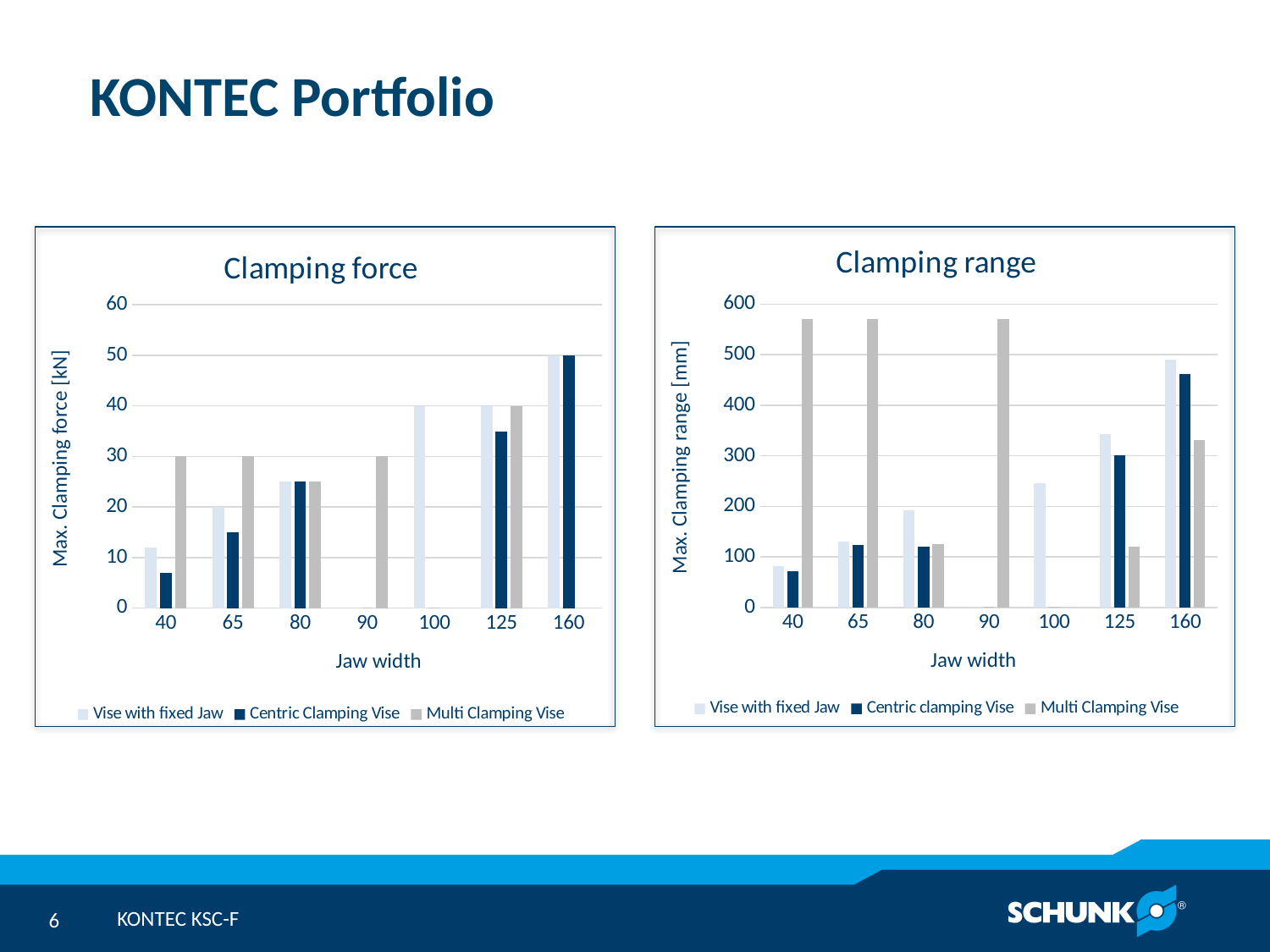
In the Clamping force chart, what kind of chart is shown? Bar chart In the Clamping range chart, at which jaw width is the Centric clamping Vise value highest? 160 In the Clamping force chart, what is the value for Vise with fixed Jaw at jaw width 160? 50 In the Clamping force chart, at jaw width 125, which is larger: Vise with fixed Jaw or Centric Clamping Vise? Vise with fixed Jaw In the Clamping force chart, what is the value for Multi Clamping Vise at jaw width 40? 30 In the Clamping range chart, is the value for Vise with fixed Jaw at jaw width 100 greater or less than 200? greater In the Clamping force chart, how many series does the legend list? 3 In the Clamping range chart, is the value for Multi Clamping Vise at jaw width 40 greater or less than 500? greater In the Clamping range chart, what is the title of the y axis? Max. Clamping range [mm] In the Clamping range chart, how many jaw width categories are shown on the x axis? 7 In the Clamping range chart, does the Centric clamping Vise value rise or fall from jaw width 80 to jaw width 160? rise